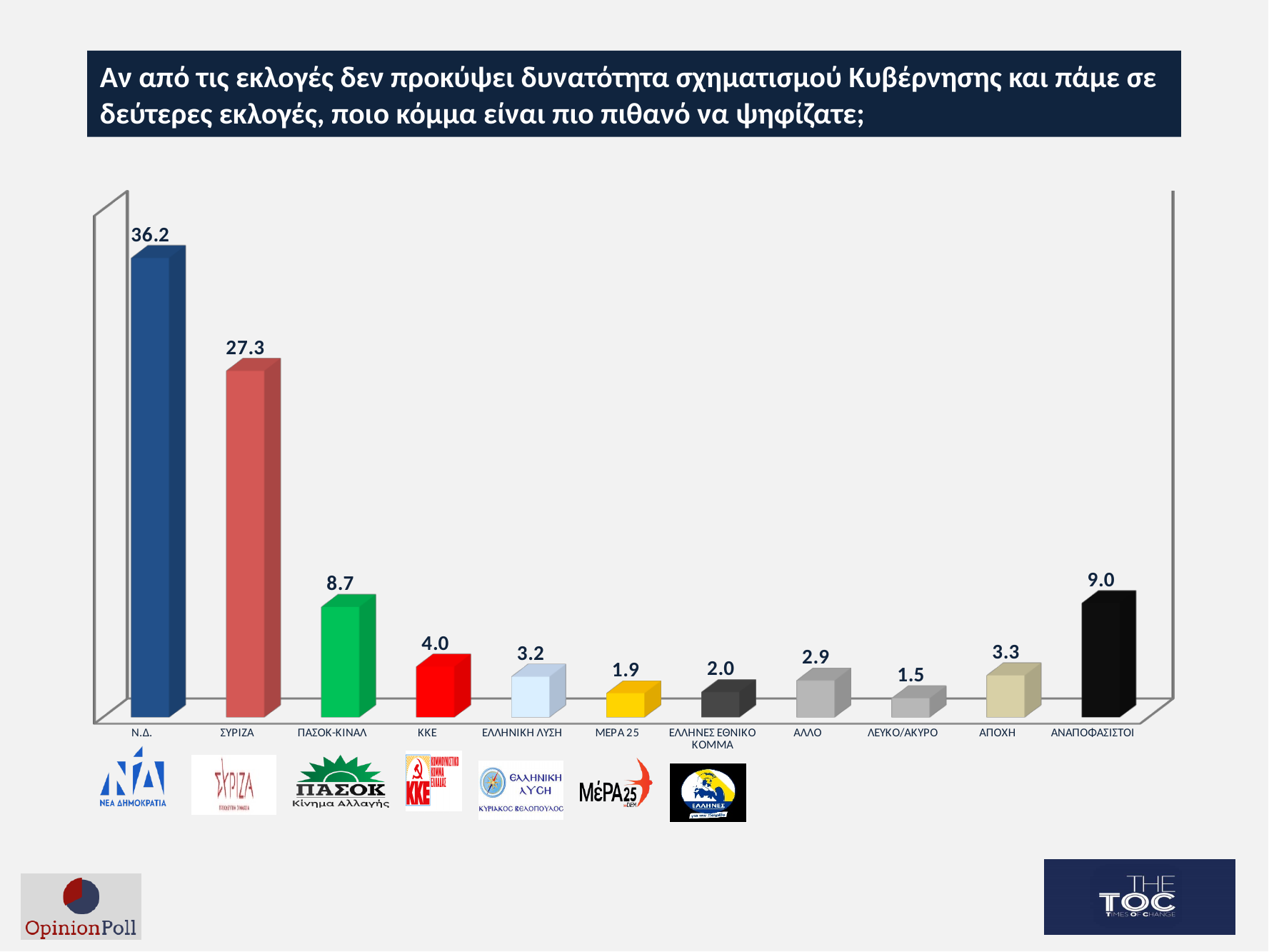
What kind of chart is shown on the slide? bar chart What is the value for Ν.Δ.? 36.2 What is the value for ΣΥΡΙΖΑ? 27.3 Which is larger, the value for ΠΑΣΟΚ-ΚΙΝΑΛ or the value for ΑΝΑΠΟΦΑΣΙΣΤΟΙ? ΑΝΑΠΟΦΑΣΙΣΤΟΙ Which category has the lowest value? ΛΕΥΚΟ/ΑΚΥΡΟ What is the value for ΚΚΕ? 4.0 What is the difference between the values for Ν.Δ. and ΣΥΡΙΖΑ? 8.9 What is the value for ΑΝΑΠΟΦΑΣΙΣΤΟΙ? 9.0 How many categories are shown on the x axis? 11 Which category has the highest value? Ν.Δ. What is the value for ΠΑΣΟΚ-ΚΙΝΑΛ? 8.7 What colour is the bar for ΣΥΡΙΖΑ? red